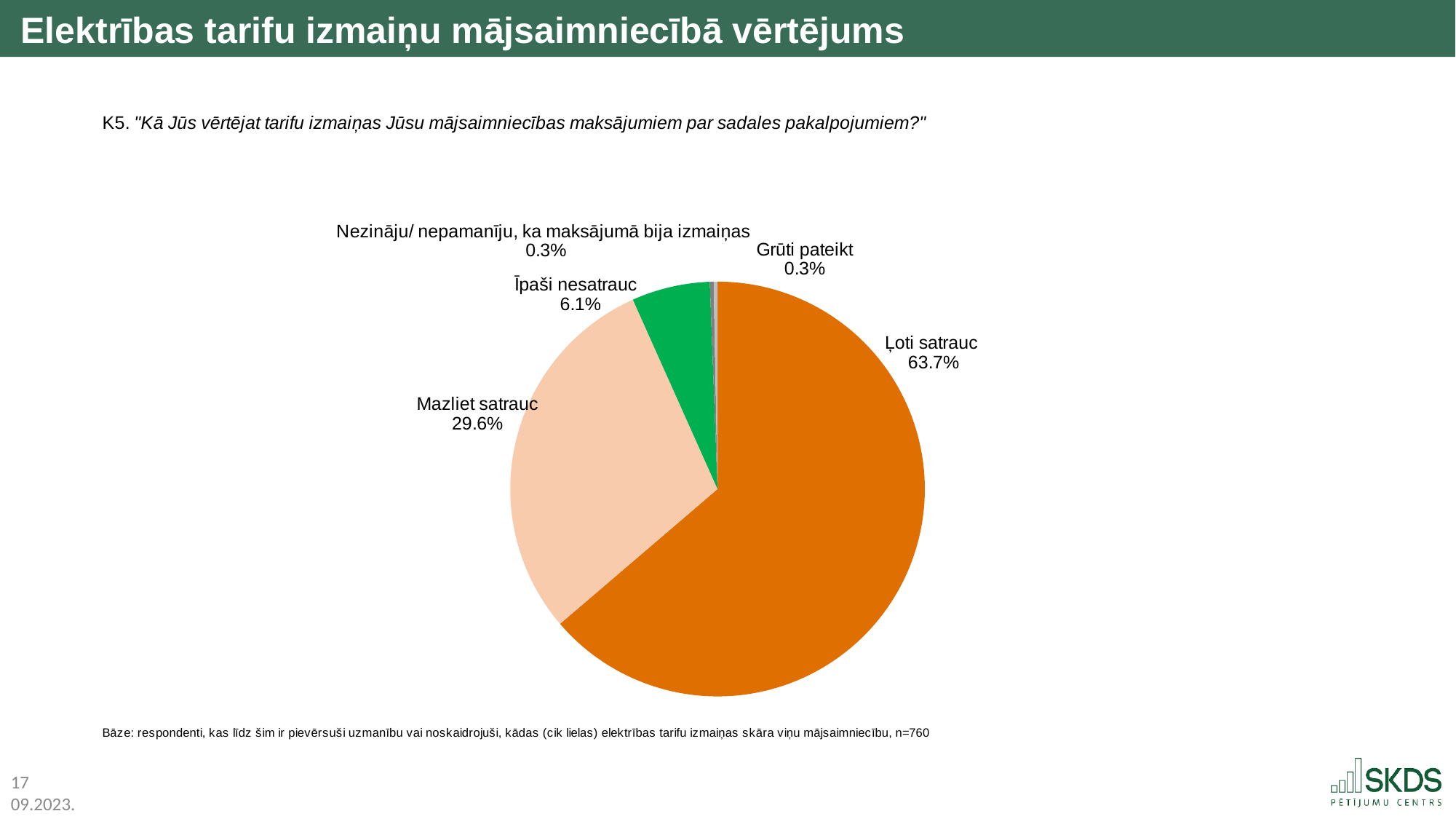
What share of respondents answered "Grūti pateikt"? 0.3% What colour is the "Īpaši nesatrauc" slice? green What share of respondents answered "Īpaši nesatrauc"? 6.1% What share of respondents answered "Mazliet satrauc"? 29.6% What share of respondents answered "Ļoti satrauc"? 63.7% What is the sample size (n) stated in the base note below the chart? n=760 What is the difference in percentage points between "Ļoti satrauc" and "Mazliet satrauc"? 34.1 How many slices (answer categories) does the pie chart have? 5 What kind of chart is shown on the slide? pie chart What is the combined share of "Ļoti satrauc" and "Mazliet satrauc"? 93.3% Which answer category has the largest slice of the pie? Ļoti satrauc Which is larger: the share for "Mazliet satrauc" or the share for "Īpaši nesatrauc"? Mazliet satrauc